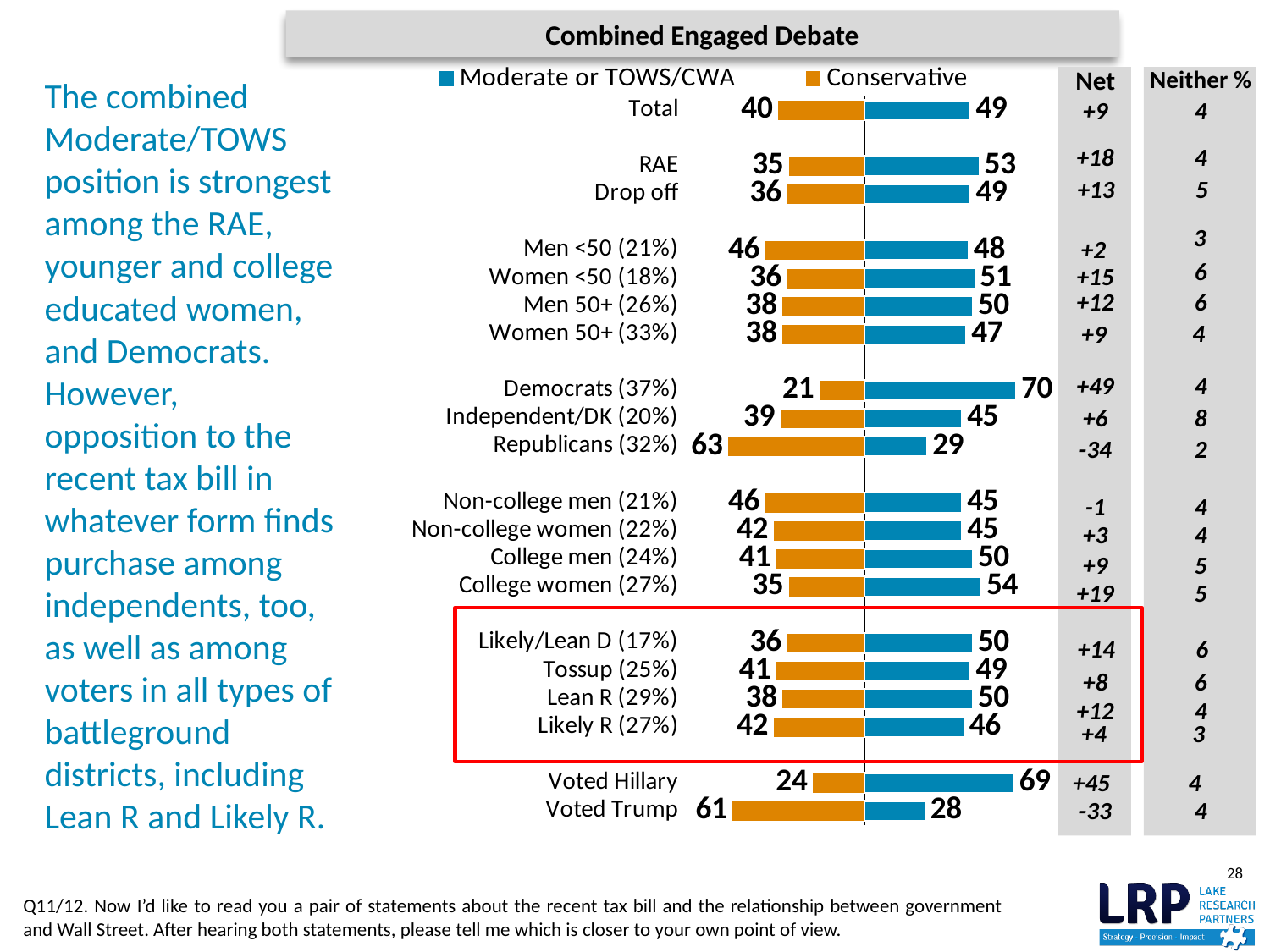
What is the difference between the Moderate or TOWS/CWA and Conservative values for College women (27%)? 19 What is the title of the chart? Combined Engaged Debate Which category has the highest Moderate or TOWS/CWA value? Democrats (37%) How many series does the legend list? 2 What is the Moderate or TOWS/CWA value for Total? 49 How many categories are plotted in the chart? 20 Which category has the lowest Conservative value? Democrats (37%) What is the Conservative value for Republicans (32%)? 63 What is the Conservative value for Voted Hillary? 24 What is the Moderate or TOWS/CWA value for Democrats (37%)? 70 For Voted Trump, which is larger: the Conservative value or the Moderate or TOWS/CWA value? Conservative What kind of chart is shown on the slide? Bar chart